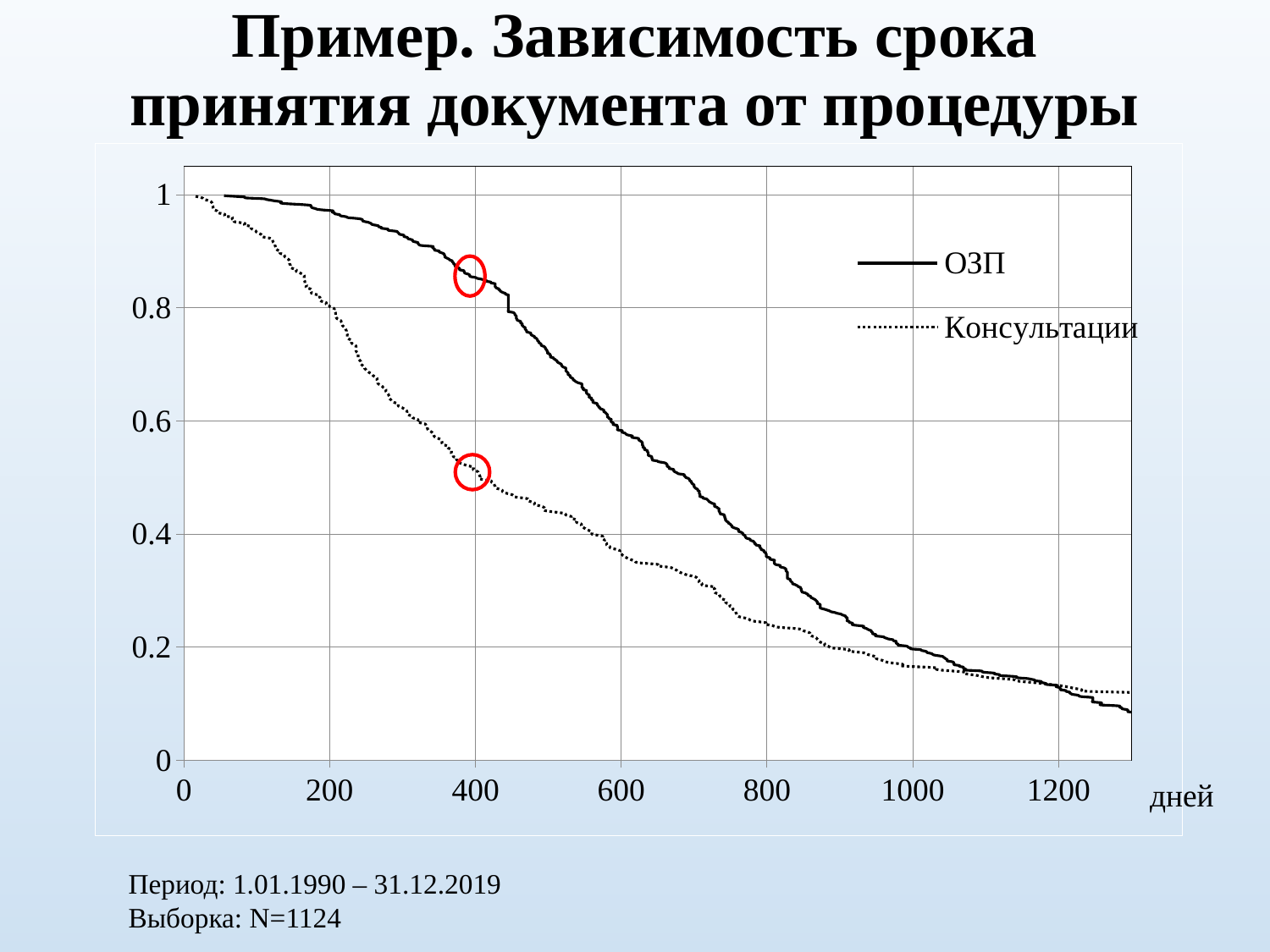
Which series is drawn with a dotted line? Консультации Do the values of the ОЗП series rise or fall as the number of days increases? fall What kind of chart is shown on the slide? line chart Is the value of the ОЗП series at 1200 days greater or less than 0.2? less What is the label shown at the end of the x axis? дней At 800 days, which series has the higher value, ОЗП or Консультации? ОЗП Do the values of the Консультации series rise or fall along the x axis? fall Is the value of the ОЗП series at 400 days greater or less than 0.8? greater How many series does the legend list? 2 At 400 days, which series has the higher value, ОЗП or Консультации? ОЗП Is the value of the ОЗП series at 800 days greater or less than 0.4? less